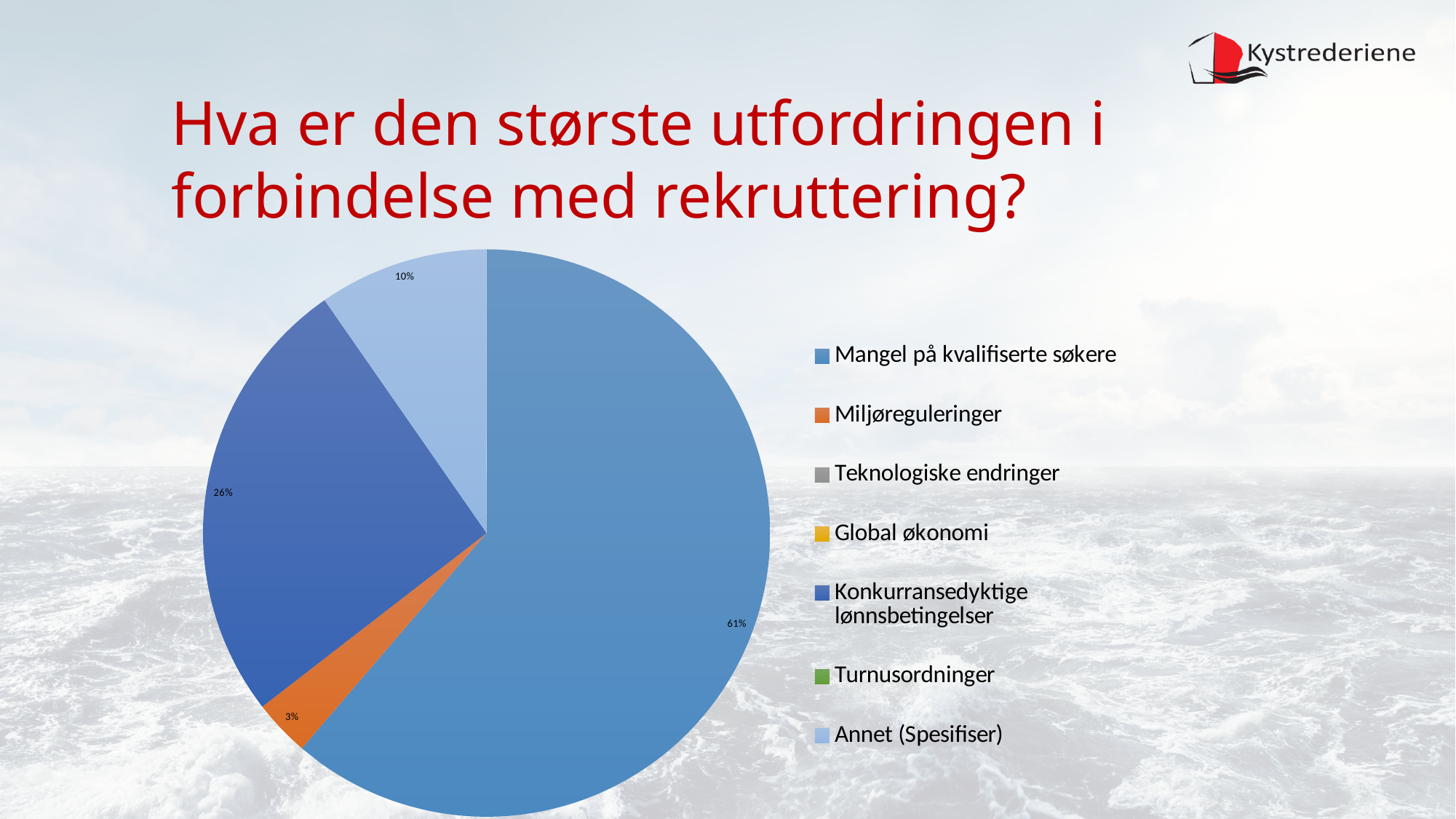
What kind of chart is shown on the slide? pie chart Which category has the largest slice of the pie? Mangel på kvalifiserte søkere Which of the labelled slices is the smallest? Miljøreguleringer What is the difference in percentage points between the "Mangel på kvalifiserte søkere" slice and the "Konkurransedyktige lønnsbetingelser" slice? 35 What share of the pie is labelled for "Konkurransedyktige lønnsbetingelser"? 26% What share of the pie is labelled for "Miljøreguleringer"? 3% How many slices with percentage labels are visible in the pie? 4 What share of the pie is labelled for "Mangel på kvalifiserte søkere"? 61% Which slice is larger: "Annet (Spesifiser)" or "Miljøreguleringer"? Annet (Spesifiser) How many entries does the legend list? 7 What share of the pie is labelled for "Annet (Spesifiser)"? 10% What is the title of the slide above the chart? Hva er den største utfordringen i forbindelse med rekruttering?